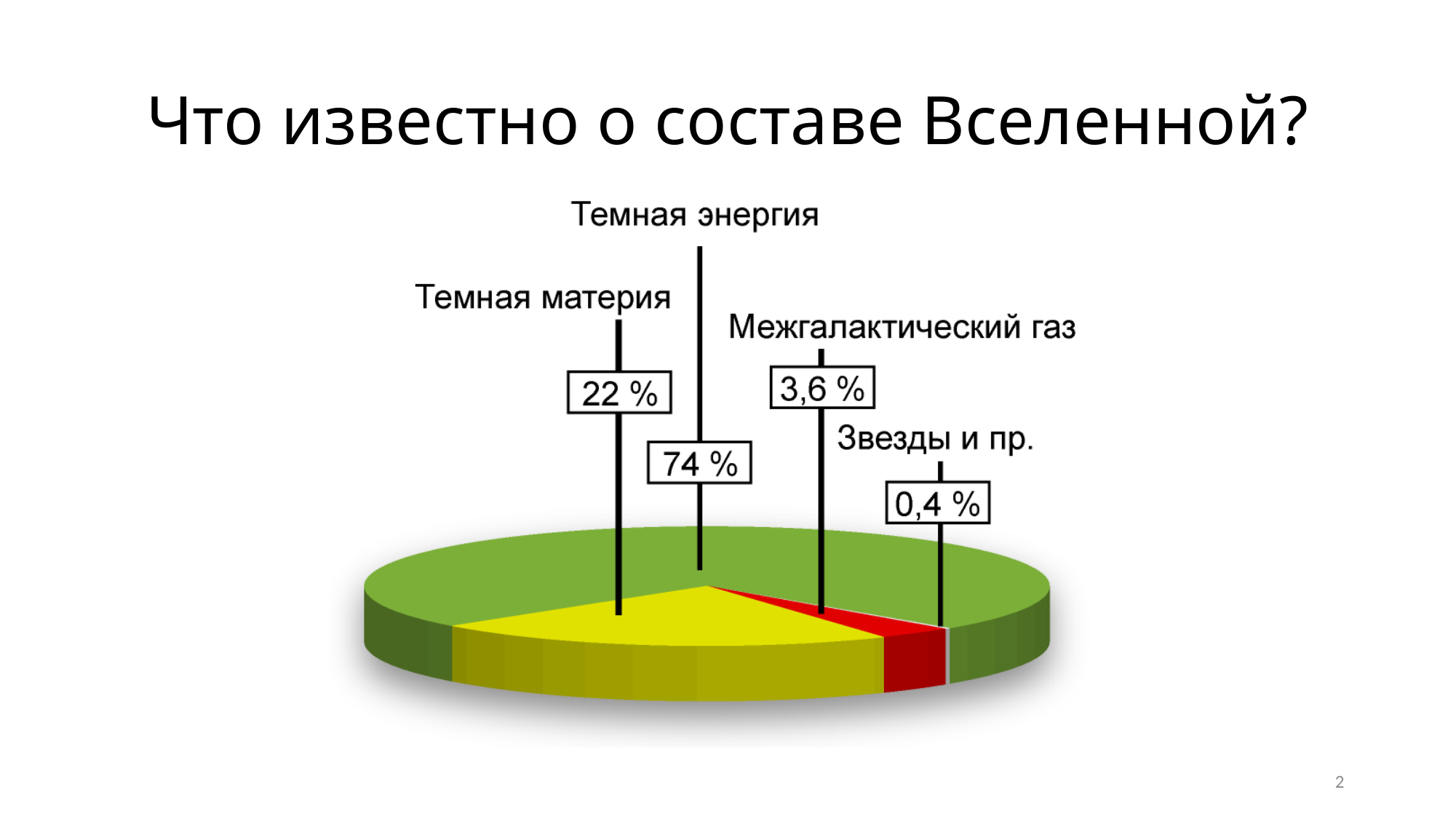
Which is larger, the value for Темная материя or the value for Межгалактический газ? Темная материя What is the difference between the values for Межгалактический газ and Звезды и пр.? 3,2 % What is the value shown for Звезды и пр.? 0,4 % What is the value shown for Межгалактический газ? 3,6 % Which category has the smallest slice of the pie? Звезды и пр. Which category has the largest slice of the pie? Темная энергия What share of the pie does Темная энергия have? 74 % What is the difference between the values for Темная энергия and Темная материя? 52 % What kind of chart is shown on the slide? Pie chart How many categories are shown in the pie chart? 4 What is the title of the slide containing the chart? Что известно о составе Вселенной? What is the value shown for Темная материя? 22 %